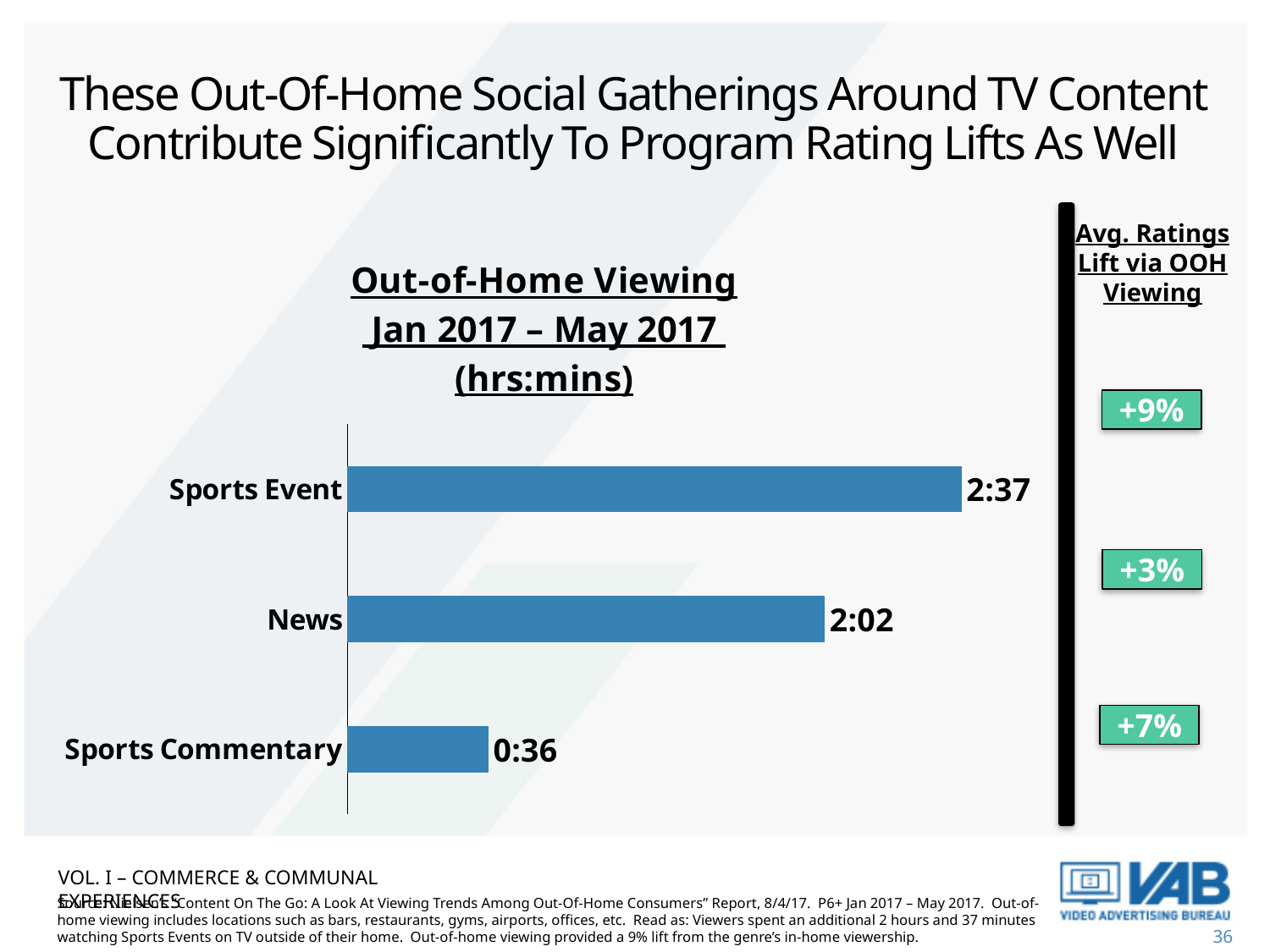
How many categories are shown in the chart? 3 What kind of chart is shown on the slide? Bar chart What is the average ratings lift via OOH viewing shown next to News? +3% What is the average ratings lift via OOH viewing shown next to Sports Commentary? +7% Which category has the highest out-of-home viewing? Sports Event What is the out-of-home viewing value for Sports Event? 2:37 What unit does the chart title say the values are in? hrs:mins Which has more out-of-home viewing, News or Sports Commentary? News What is the out-of-home viewing value for Sports Commentary? 0:36 What is the average ratings lift via OOH viewing shown next to Sports Event? +9% What is the out-of-home viewing value for News? 2:02 Which category has the lowest out-of-home viewing? Sports Commentary